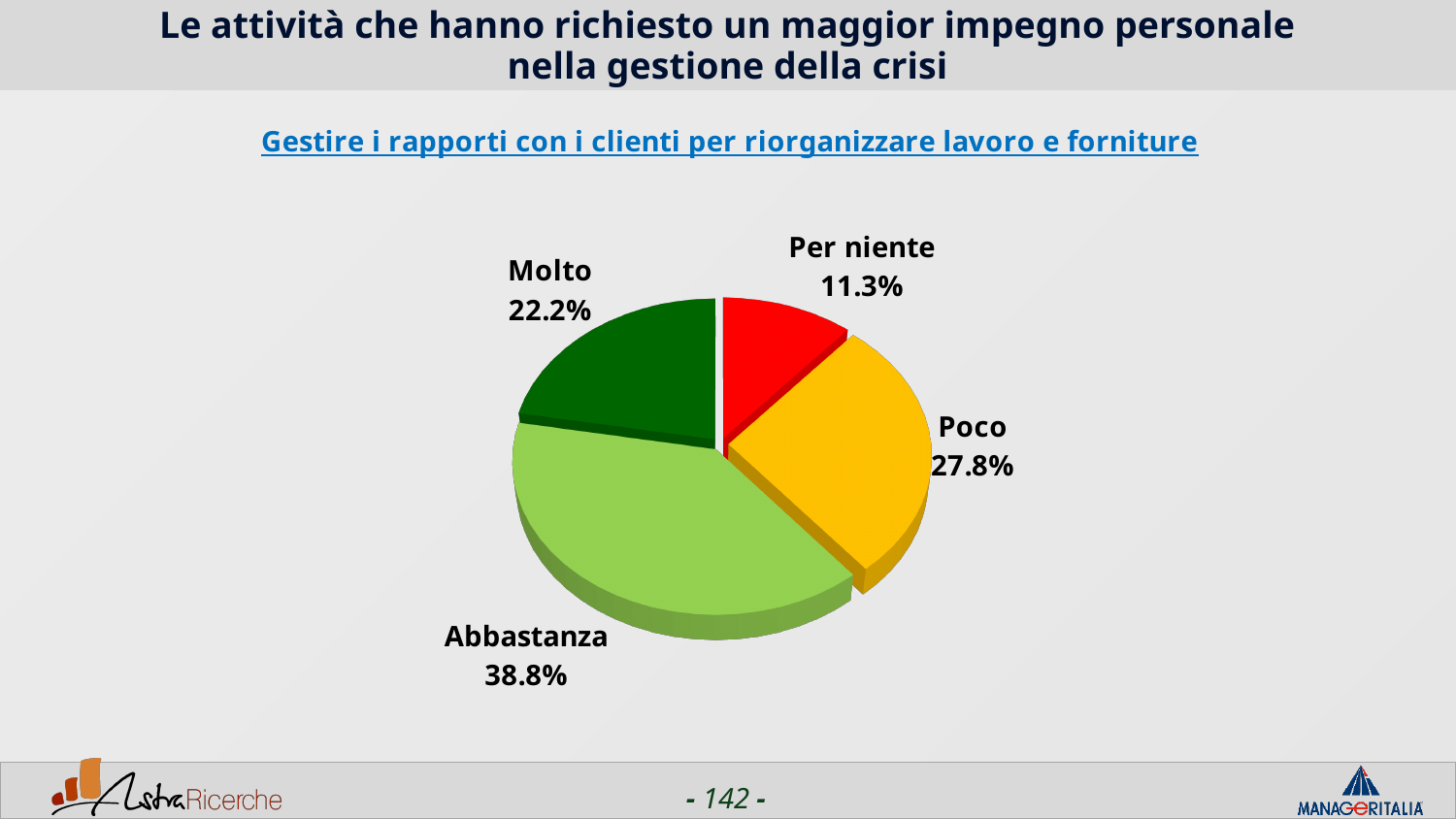
What is the value for Abbastanza? 38.8% What is the value for Molto? 22.2% What is the difference between the values for Abbastanza and Poco? 11.0 percentage points What is the value for Per niente? 11.3% How many slices does the pie chart have? 4 What is the value for Poco? 27.8% Which category has the smallest share of the pie? Per niente Which category has the largest share of the pie? Abbastanza What kind of chart is shown on the slide? pie chart Which is larger, the value for Poco or the value for Molto? Poco What is the difference between the values for Molto and Per niente? 10.9 percentage points What colour is the Per niente slice? red